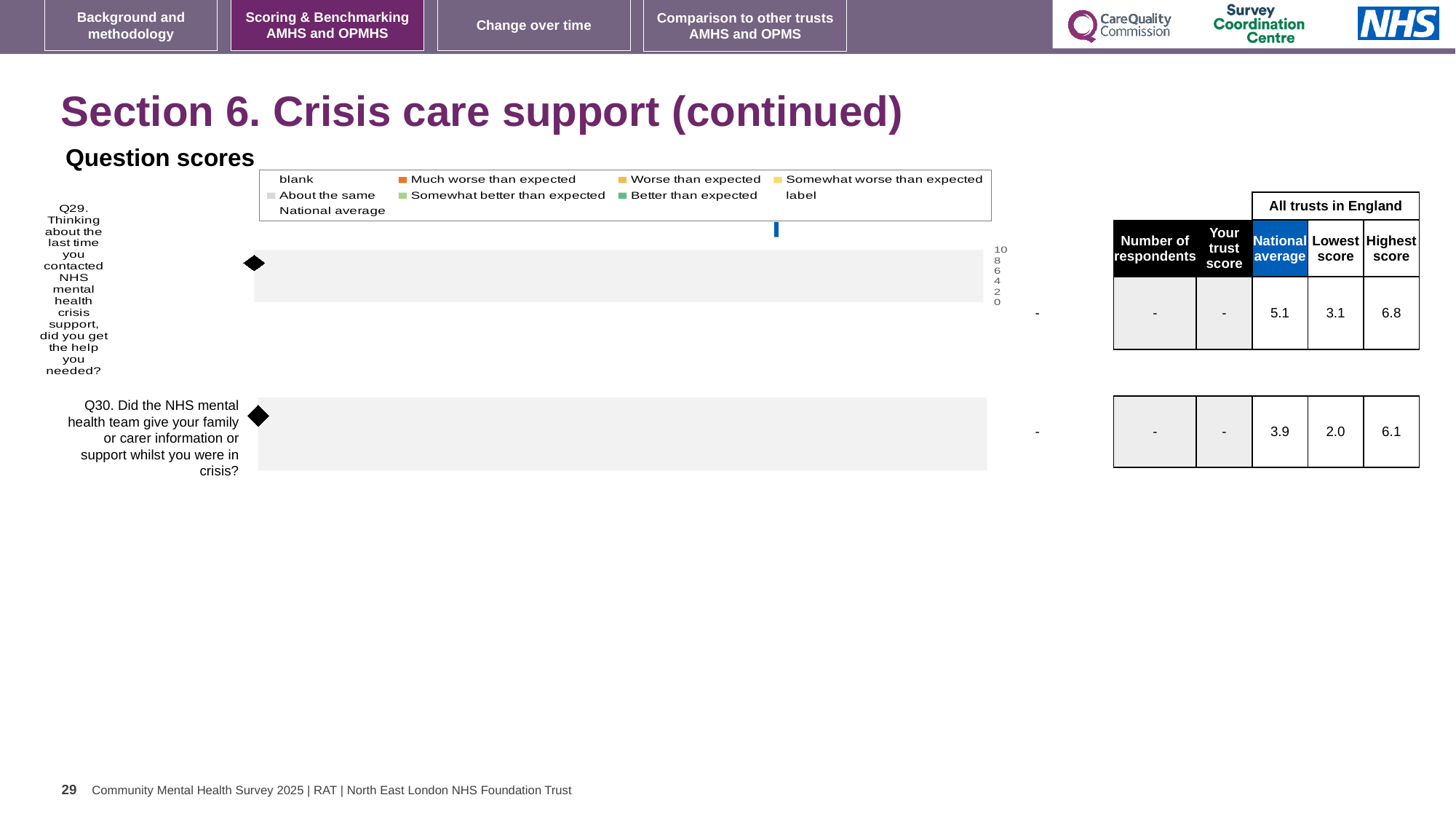
Which colour does the legend use for 'Much worse than expected'? orange In the table beside the chart, what is the national average score for Q30? 3.9 How many questions (categories) are plotted in the chart? 2 What kind of chart is shown under 'Question scores'? bar chart In the table beside the chart, what is shown as the trust score for Q29? - What is the highest tick value shown on the chart's axis? 10 In the table beside the chart, what is the lowest score for Q30? 2.0 In the table beside the chart, which question has the higher national average, Q29 or Q30? Q29 In the table beside the chart, what is the highest score for Q29? 6.8 In the table beside the chart, what is the national average score for Q29? 5.1 In the table beside the chart, what is the difference between the highest and lowest scores for Q30? 4.1